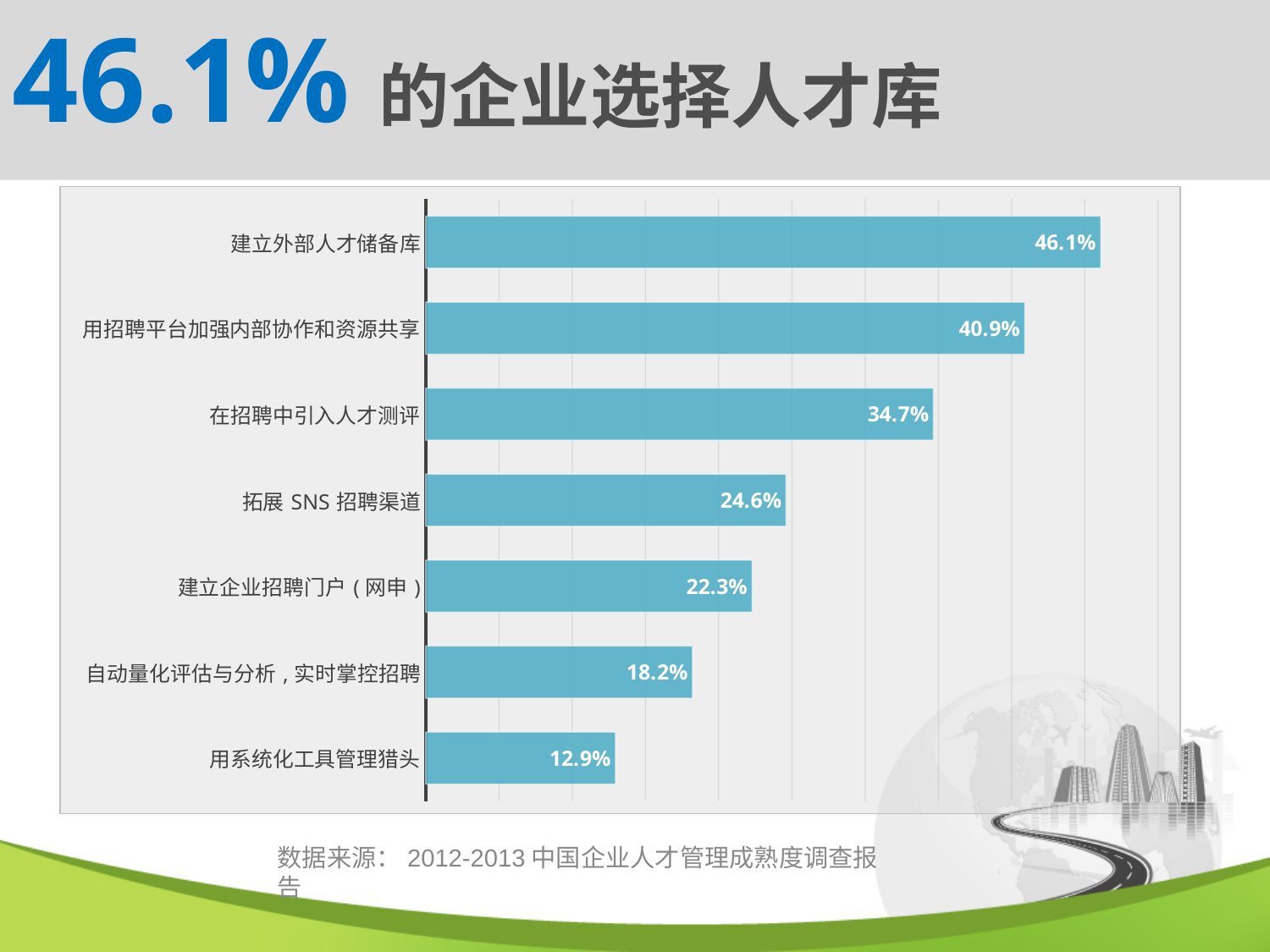
What is the value for 用系统化工具管理猎头? 12.9% What data source is cited below the chart? 2012-2013 中国企业人才管理成熟度调查报告 Which category has the lowest value? 用系统化工具管理猎头 What is the value for 在招聘中引入人才测评? 34.7% What is the difference between the values for 拓展 SNS 招聘渠道 and 用系统化工具管理猎头? 11.7% What is the difference between the values for 建立外部人才储备库 and 用招聘平台加强内部协作和资源共享? 5.2% How many categories are shown in the chart? 7 Which is larger, the value for 建立企业招聘门户（网申） or the value for 自动量化评估与分析，实时掌控招聘? 建立企业招聘门户（网申） What is the value for 建立外部人才储备库? 46.1% What is the value for 拓展 SNS 招聘渠道? 24.6% Which category has the highest value? 建立外部人才储备库 What kind of chart is shown on the slide? Bar chart